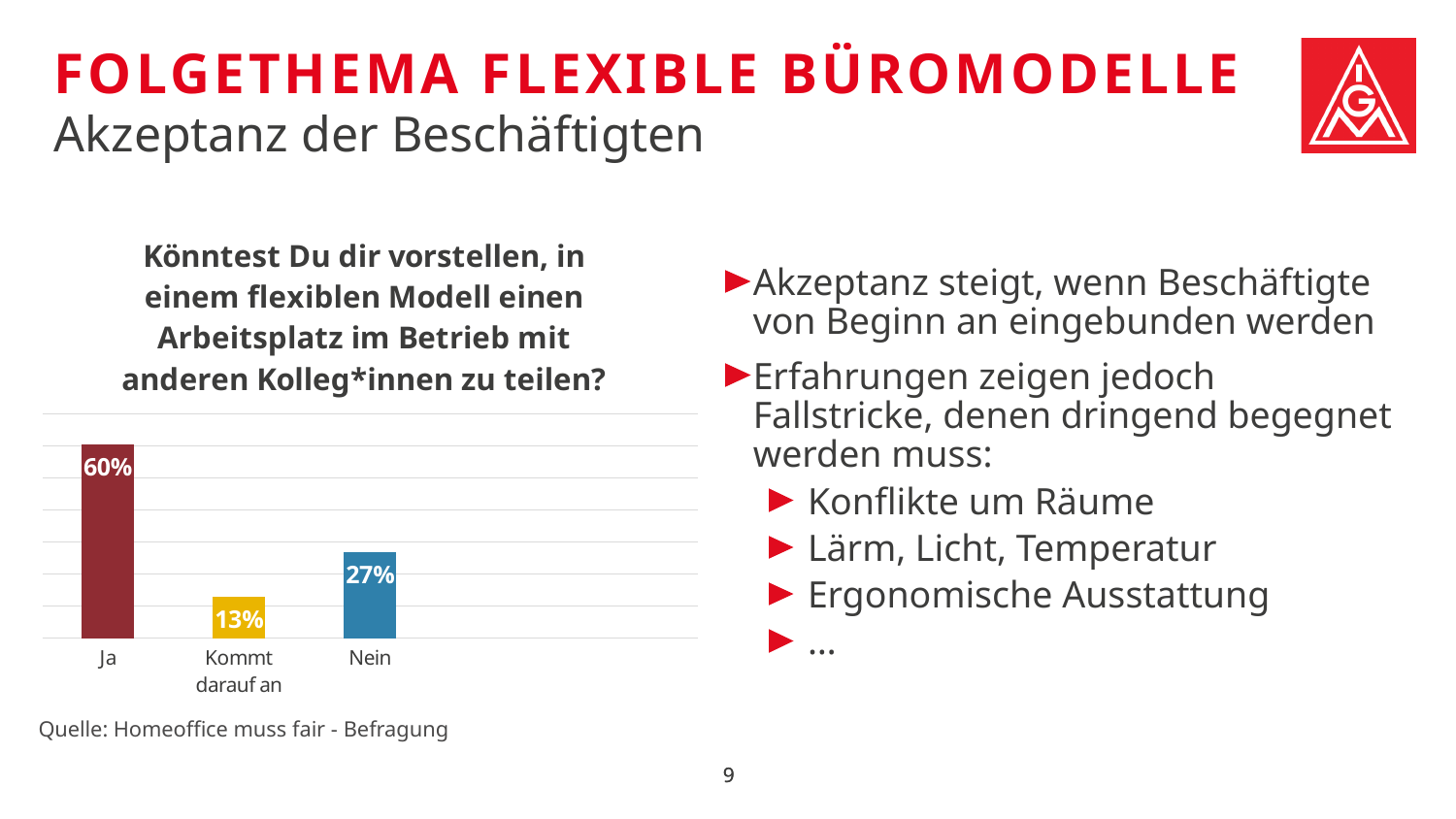
What is the difference in percentage points between "Ja" and "Nein"? 33 What percentage of respondents answered "Nein"? 27% What source is cited below the chart? Homeoffice muss fair - Befragung Which answer category has the highest value? Ja What is the difference in percentage points between "Nein" and "Kommt darauf an"? 14 What colour is the bar for "Ja"? Dark red What percentage of respondents answered "Kommt darauf an"? 13% How many answer categories are shown in the chart? 3 Which is larger, the value for "Nein" or the value for "Kommt darauf an"? Nein What percentage of respondents answered "Ja"? 60% What type of chart is shown on the slide? Bar chart Which answer category has the lowest value? Kommt darauf an